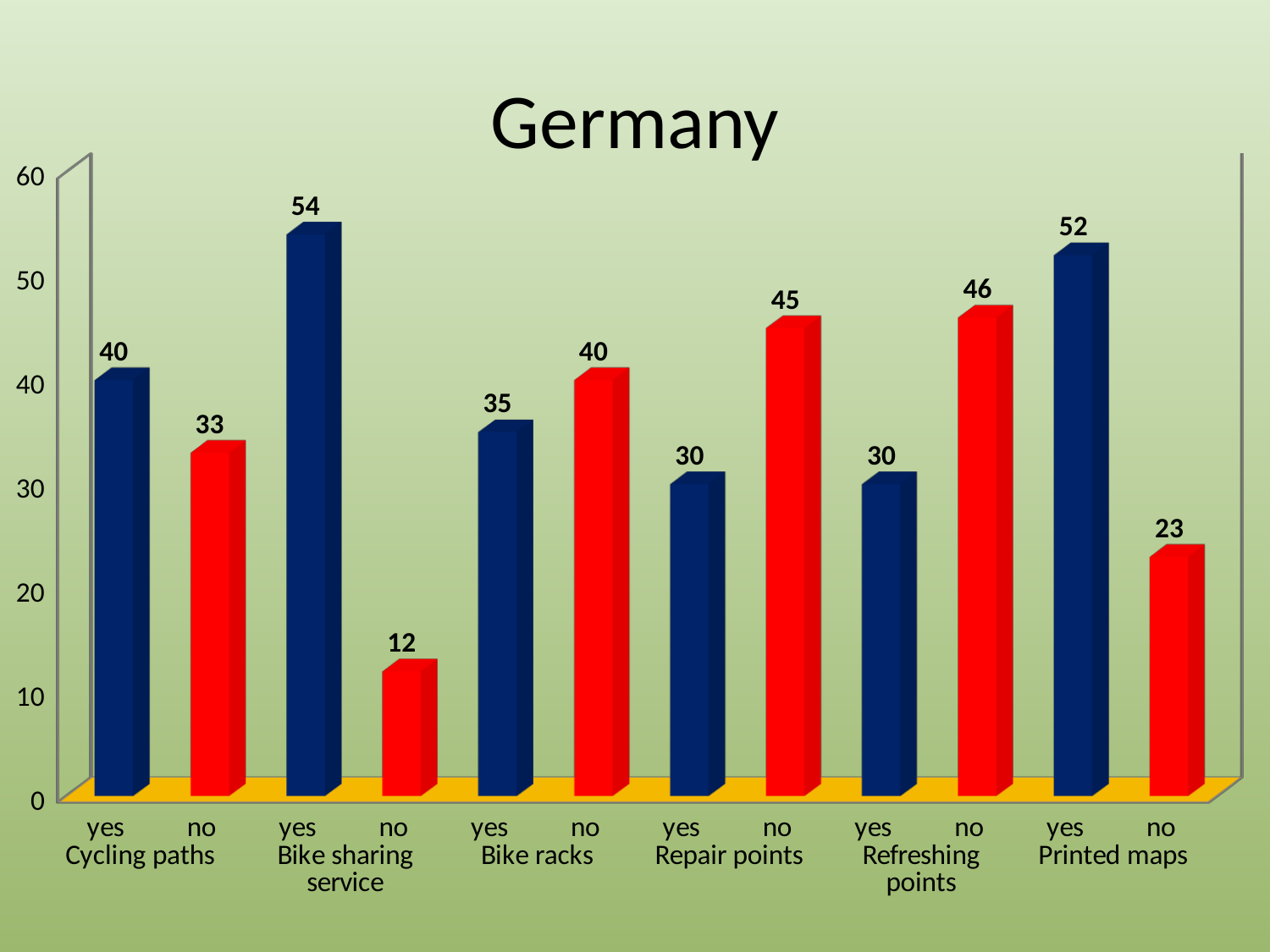
What is the title of the chart? Germany What is the difference between the 'yes' and 'no' values for Printed maps? 29 What is the difference between the 'no' and 'yes' values for Repair points? 15 How many bars are plotted on the chart? 12 Which bar has the lowest value on the chart? no, Bike sharing service What is the value for 'no' under Refreshing points? 46 What is the value for 'yes' under Printed maps? 52 What is the value for 'no' under Bike sharing service? 12 What kind of chart is shown on the slide? bar chart What is the value for 'yes' under Cycling paths? 40 Which bar has the highest value on the chart? yes, Bike sharing service Which is larger for Bike racks, the 'yes' value or the 'no' value? no